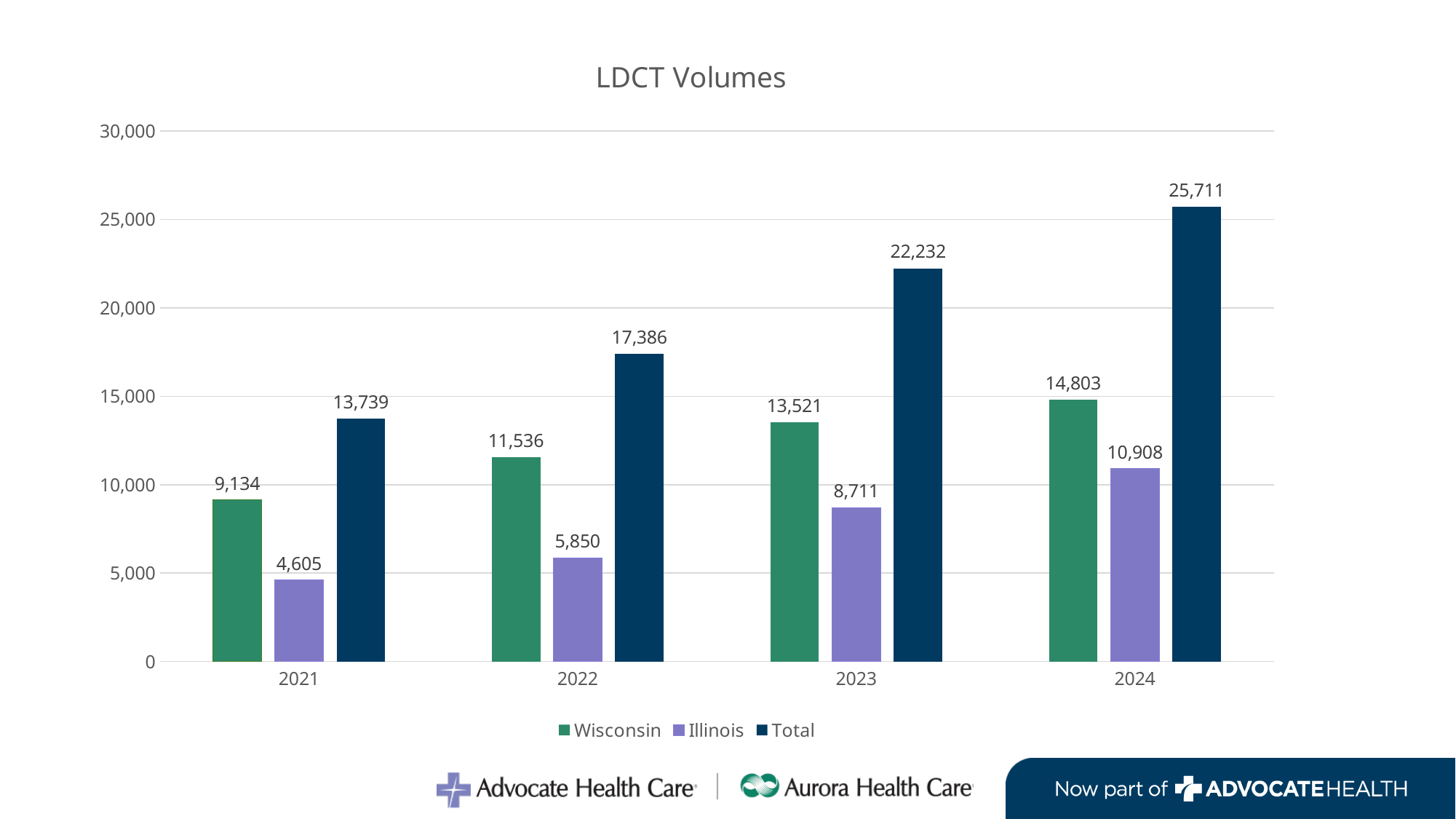
What is the Total LDCT volume for 2024? 25,711 What is the difference between the Wisconsin and Illinois volumes in 2022? 5,686 How many series does the legend list? 3 What is the Illinois LDCT volume for 2023? 8,711 What kind of chart is shown on the slide? Bar chart Which year has the highest Total LDCT volume? 2024 Which year has the lowest Illinois LDCT volume? 2021 What is the Wisconsin LDCT volume for 2021? 9,134 Is the Total volume for 2023 greater or less than 20,000? greater Which is larger in 2024, the Wisconsin volume or the Illinois volume? Wisconsin Does the Total LDCT volume rise or fall from 2021 to 2024? Rise How many years are shown on the x axis? 4